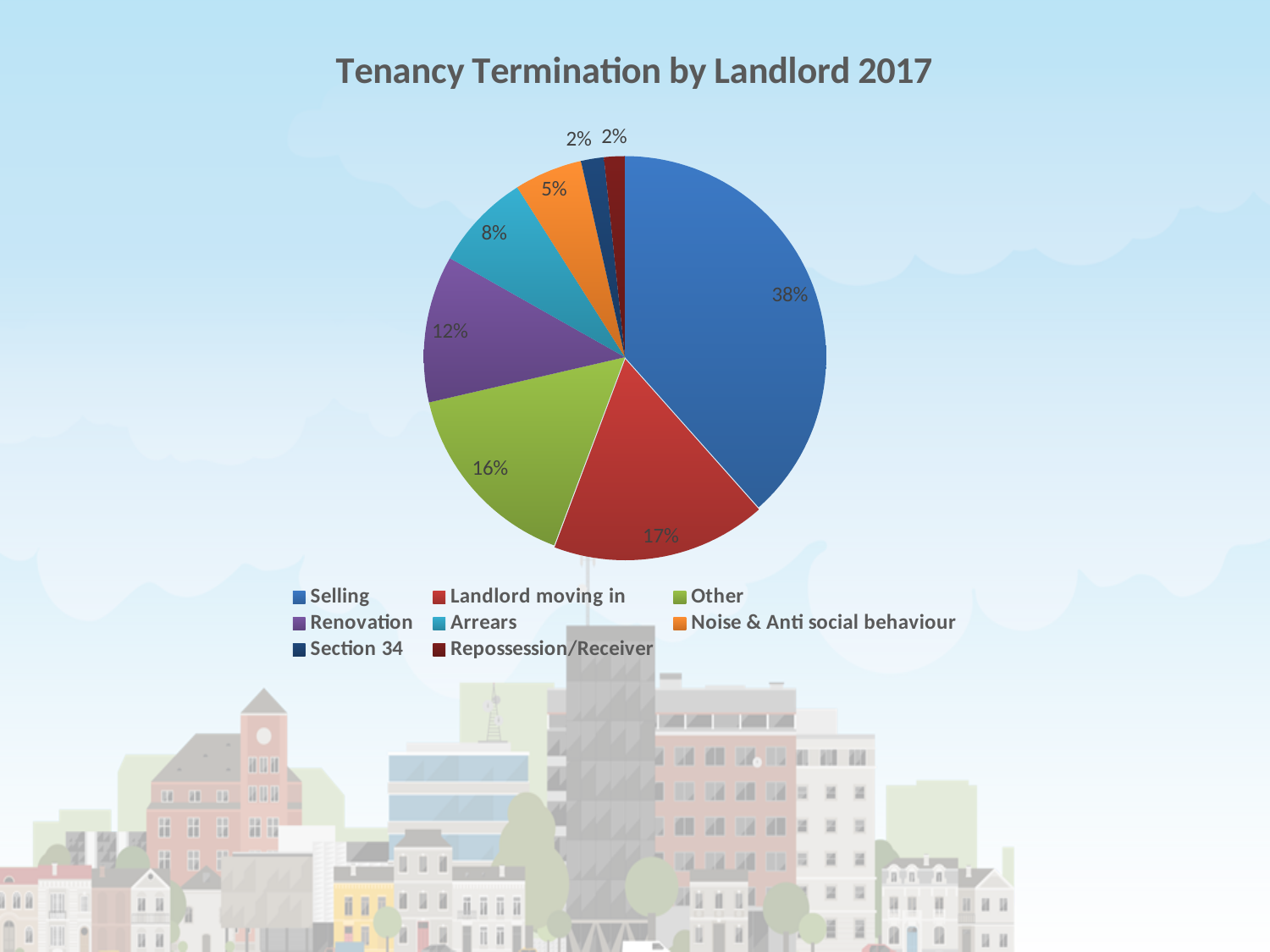
Which is larger, the share for Other or the share for Renovation? Other How many categories does the pie chart show? 8 What percentage of tenancy terminations is attributed to Noise & Anti social behaviour? 5% What percentage of tenancy terminations is attributed to Landlord moving in? 17% What percentage of tenancy terminations is attributed to Arrears? 8% What is the difference in percentage points between Selling and Landlord moving in? 21 What percentage of tenancy terminations is attributed to Selling? 38% Which reason accounts for the largest share of tenancy terminations? Selling What type of chart is shown on the slide? Pie chart What colour represents Arrears in the chart? Teal (light blue) What is the title of the chart? Tenancy Termination by Landlord 2017 What percentage of tenancy terminations is attributed to Renovation? 12%